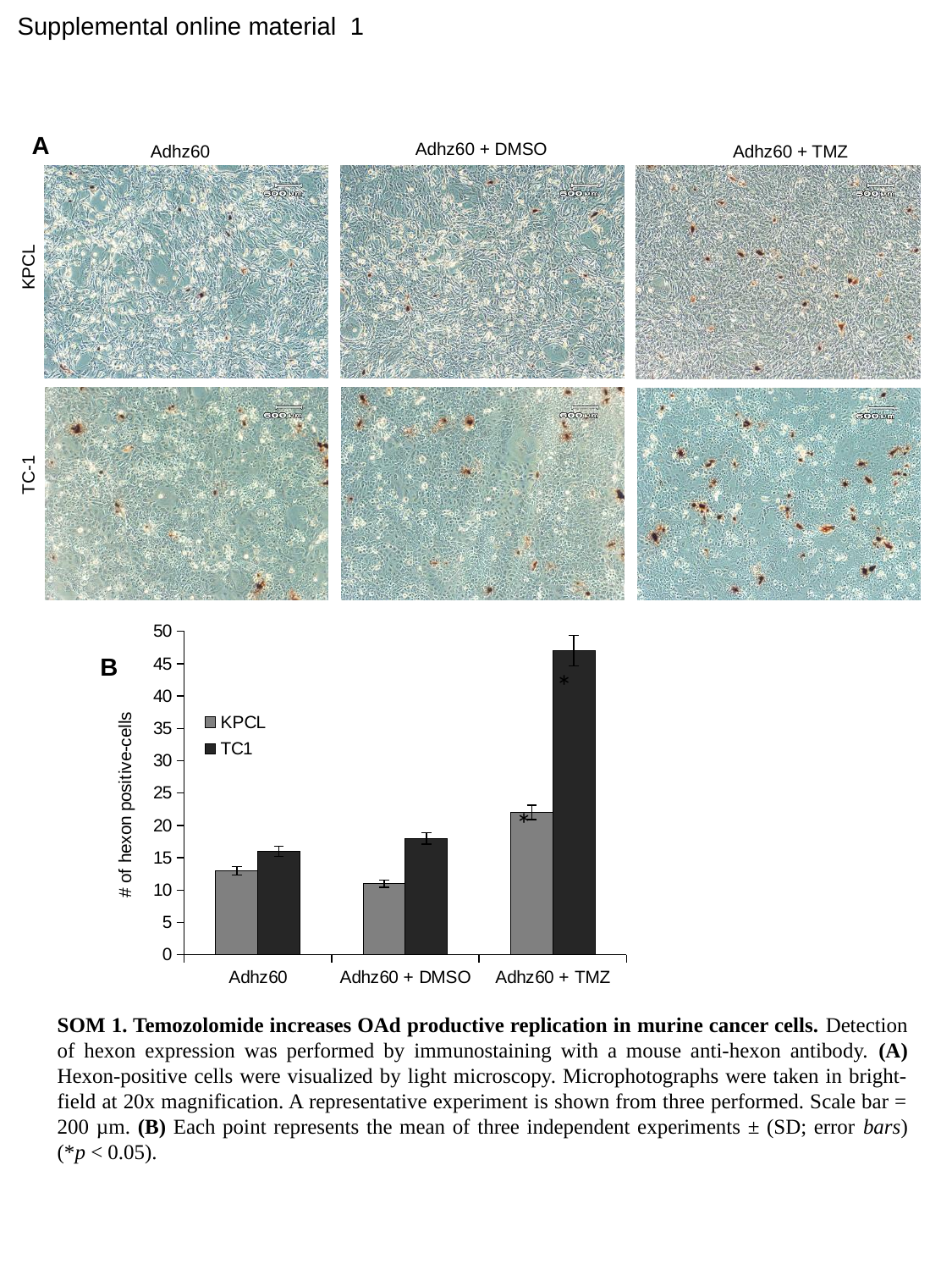
In the chart in panel B, which treatment gives the highest value for TC1? Adhz60 + TMZ In the chart in panel B, is the KPCL value for Adhz60 greater or less than 10? greater What is the y-axis label of the chart in panel B? # of hexon positive-cells How many series does the legend of the chart in panel B list? 2 In the chart in panel B, is the TC1 value for Adhz60 + TMZ greater or less than 40? greater In the chart in panel B, is the TC1 value for Adhz60 + DMSO greater or less than 20? less In the chart in panel B, which treatment gives the lowest value for KPCL? Adhz60 + DMSO What kind of chart is shown in panel B? bar chart How many treatment categories are shown on the x axis of the chart in panel B? 3 In the chart in panel B, do the TC1 values rise or fall from Adhz60 + DMSO to Adhz60 + TMZ? rise In the chart in panel B, for Adhz60 + TMZ, which series has the larger value, KPCL or TC1? TC1